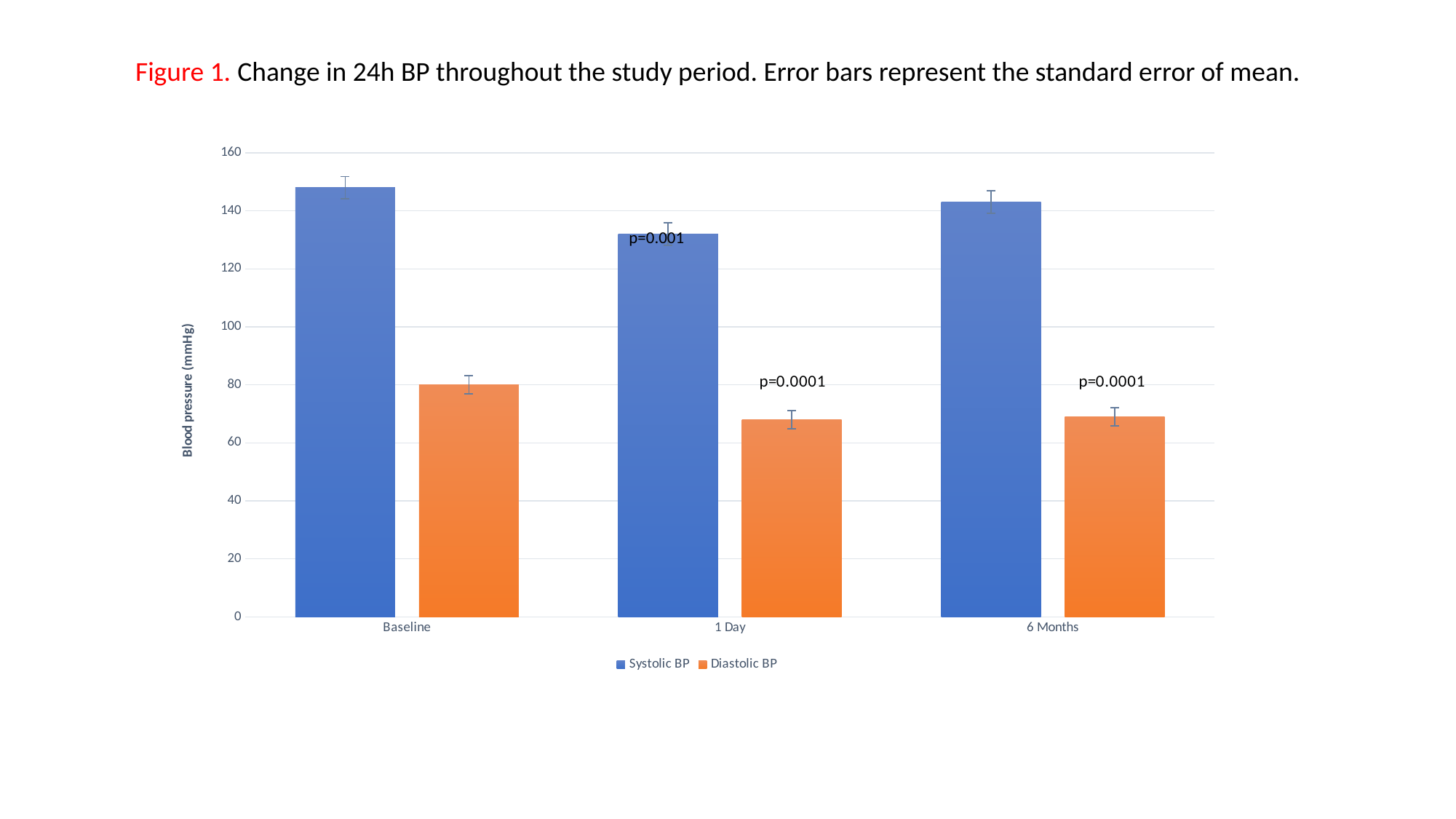
How many time-point categories are shown on the x axis? 3 What p-value is printed above the Diastolic BP bar at 6 Months? p=0.0001 How many series does the legend list? 2 What kind of chart is shown on the slide? bar chart What is the Diastolic BP value at Baseline? 80 At which time point is Systolic BP highest? Baseline Is the Systolic BP value at 1 Day greater or less than 140? less At which time point is Systolic BP lowest? 1 Day Is the Systolic BP value at Baseline greater or less than 140? greater What is the label on the vertical axis? Blood pressure (mmHg) Which is larger, Systolic BP at 1 Day or at 6 Months? 6 Months Is the Diastolic BP value at 1 Day greater or less than 80? less